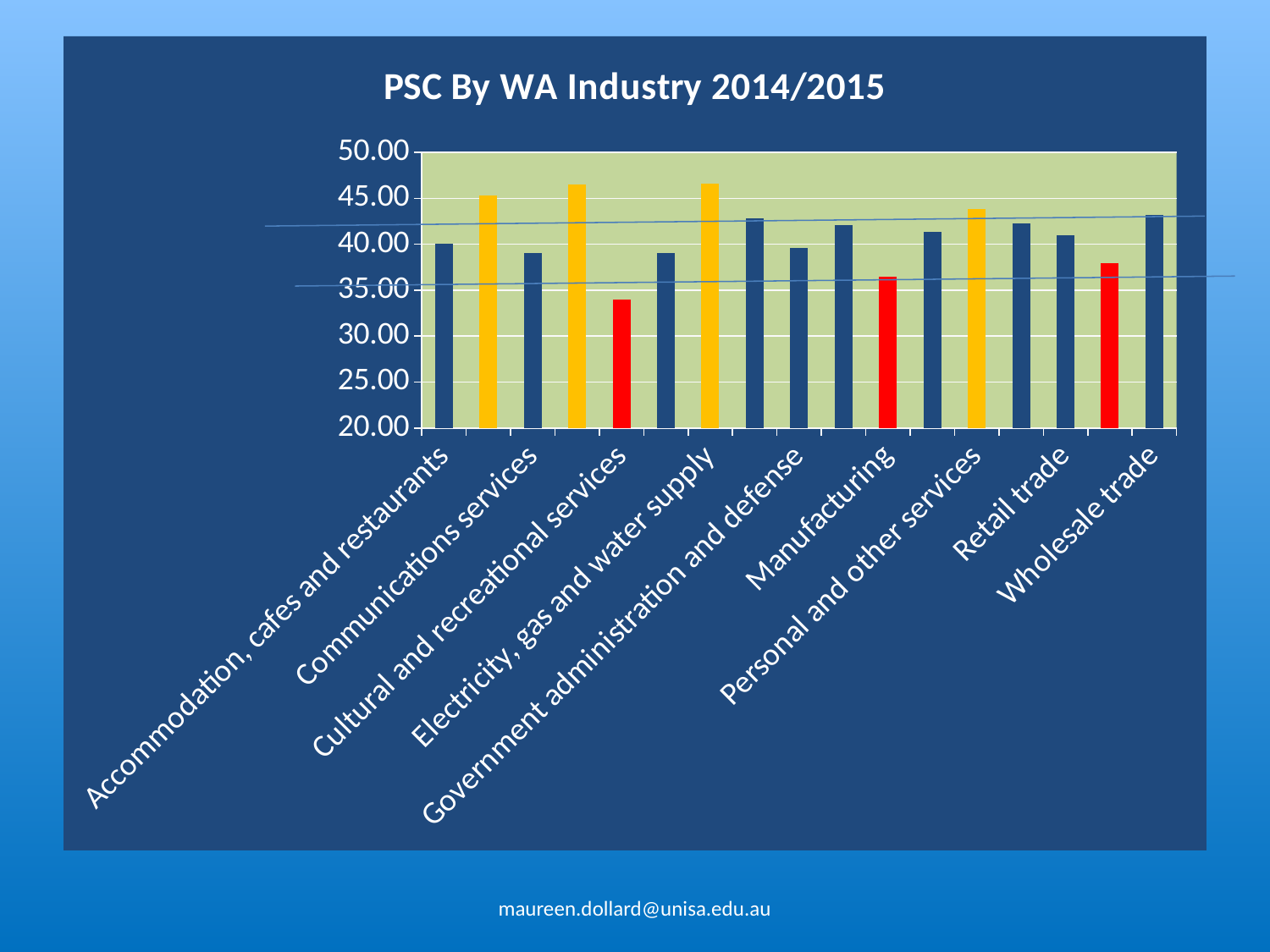
What is the title of the chart? PSC By WA Industry 2014/2015 How many bars are plotted in the chart? 17 Is the value for Wholesale trade greater or less than 40? greater Is the value for Communications services greater or less than 40? less Is the value for Personal and other services greater or less than 40? greater What kind of chart is shown on the slide? bar chart Which of the labelled industries has the highest bar? Electricity, gas and water supply Which of the labelled industries has the lowest bar? Cultural and recreational services Which is larger, the value for Wholesale trade or the value for Manufacturing? Wholesale trade